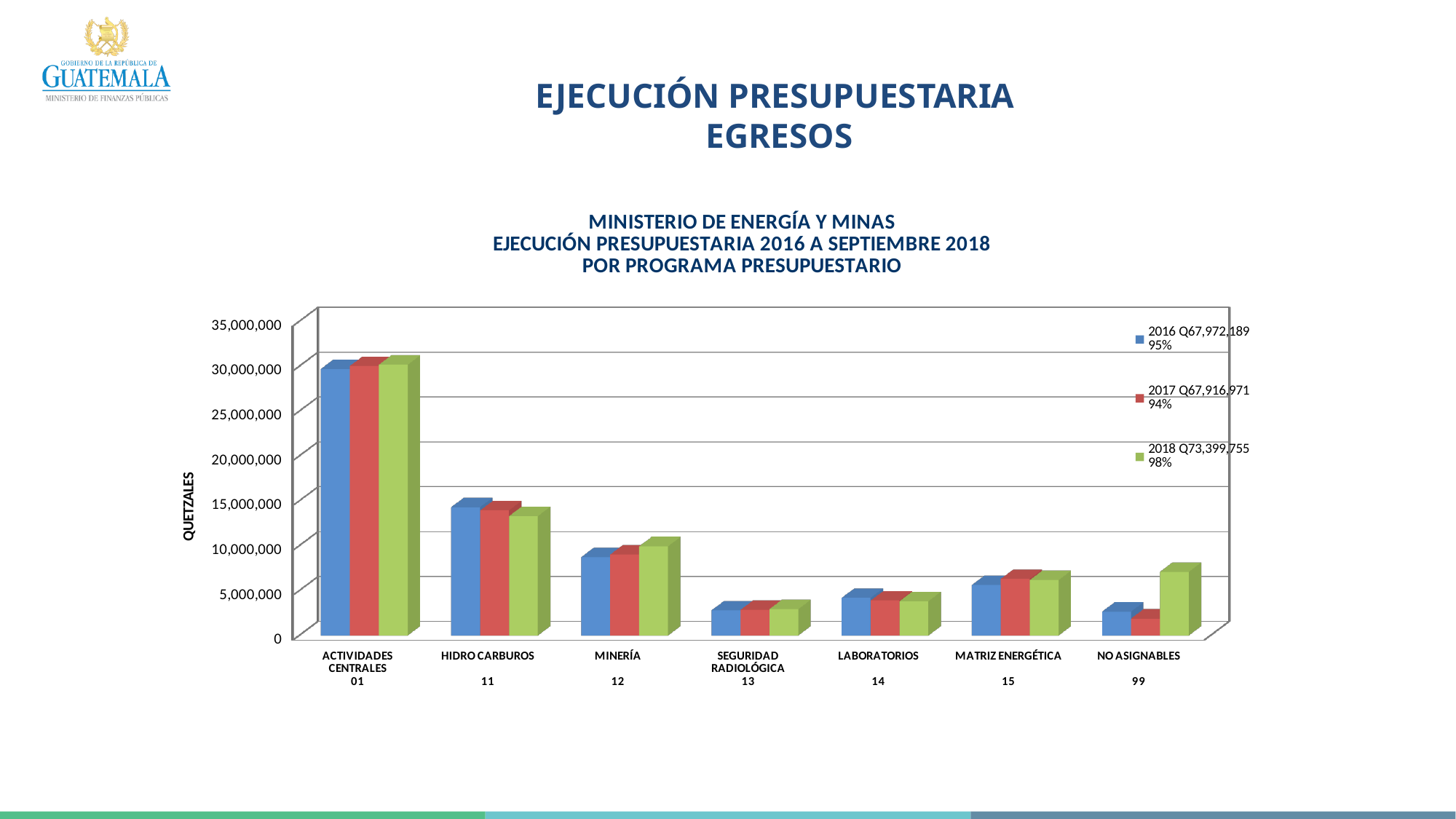
How many programme categories are shown on the x axis of the chart? 7 What kind of chart is shown on the slide? bar chart Which category has the highest bars in the chart? ACTIVIDADES CENTRALES 01 What execution percentage does the legend show for 2017? 94% For NO ASIGNABLES, which year has the larger value: 2017 or 2018? 2018 What total amount does the legend show for 2018? Q73,399,755 Is the 2018 value for HIDRO CARBUROS greater or less than 15,000,000? less What is the label on the chart's vertical axis? QUETZALES Is the 2016 value for MINERÍA greater or less than 5,000,000? greater Which is larger for 2016: HIDRO CARBUROS or MINERÍA? HIDRO CARBUROS Is the 2016 value for ACTIVIDADES CENTRALES greater or less than 25,000,000? greater How many series does the chart's legend list? 3